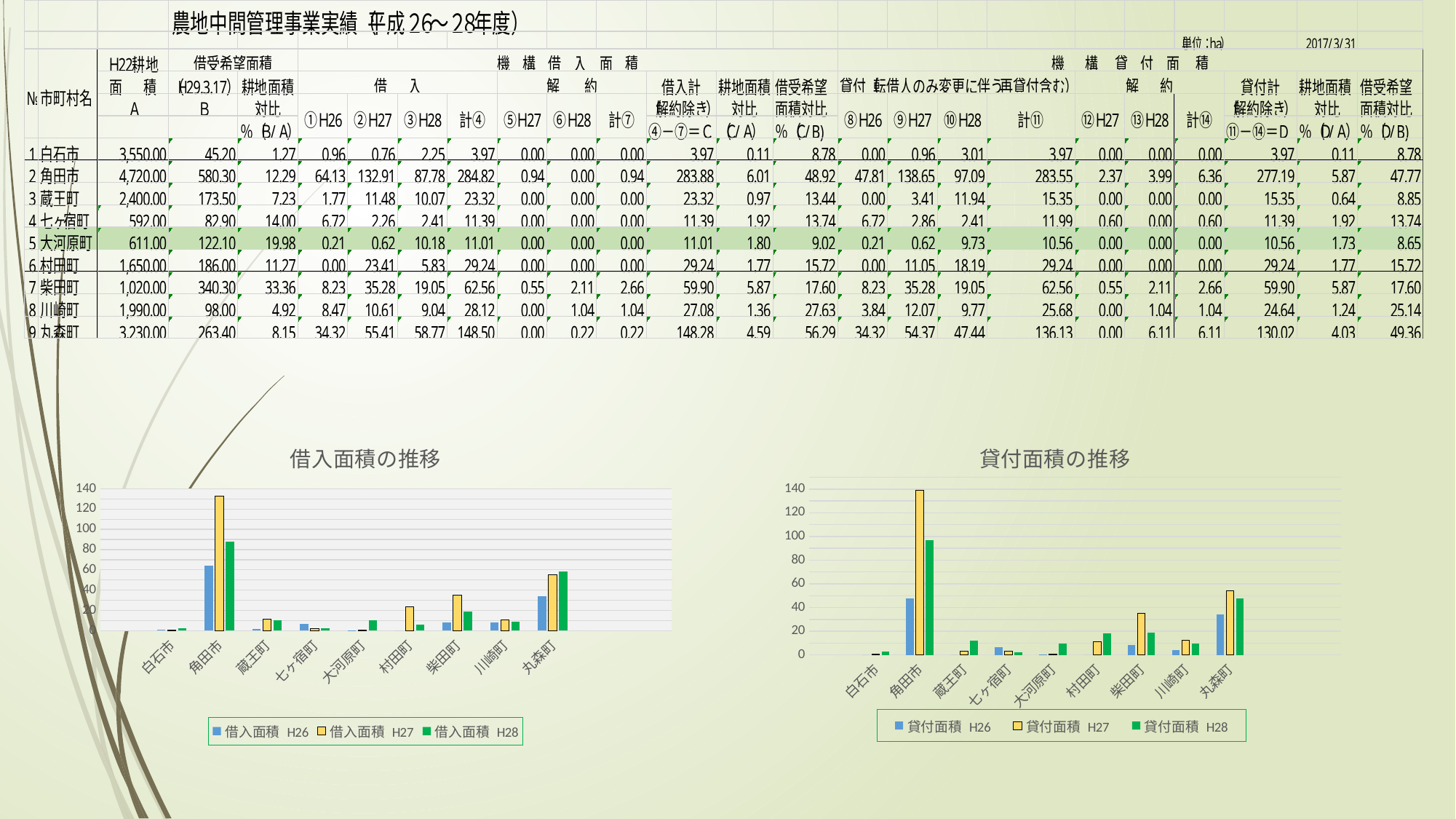
In the 貸付面積の推移 chart, is the 貸付面積 H28 value for 柴田町 greater or less than 40? less What kind of chart is the 借入面積の推移 chart? bar chart In the 借入面積の推移 chart, is the 借入面積 H27 value for 角田市 greater or less than 120? greater In the 貸付面積の推移 chart, which is larger for 貸付面積 H27: 柴田町 or 村田町? 柴田町 What colour are the H27 bars in the 貸付面積の推移 chart? yellow In the 借入面積の推移 chart, which municipality has the tallest bar? 角田市 How many series does the legend of the 貸付面積の推移 chart list? 3 In the 貸付面積の推移 chart, which series has the tallest bar for 角田市? 貸付面積 H27 In the 貸付面積の推移 chart, is the 貸付面積 H27 value for 角田市 greater or less than 120? greater In the 借入面積の推移 chart, which is larger for 借入面積 H26: 角田市 or 丸森町? 角田市 How many municipalities are shown on the x axis of the 借入面積の推移 chart? 9